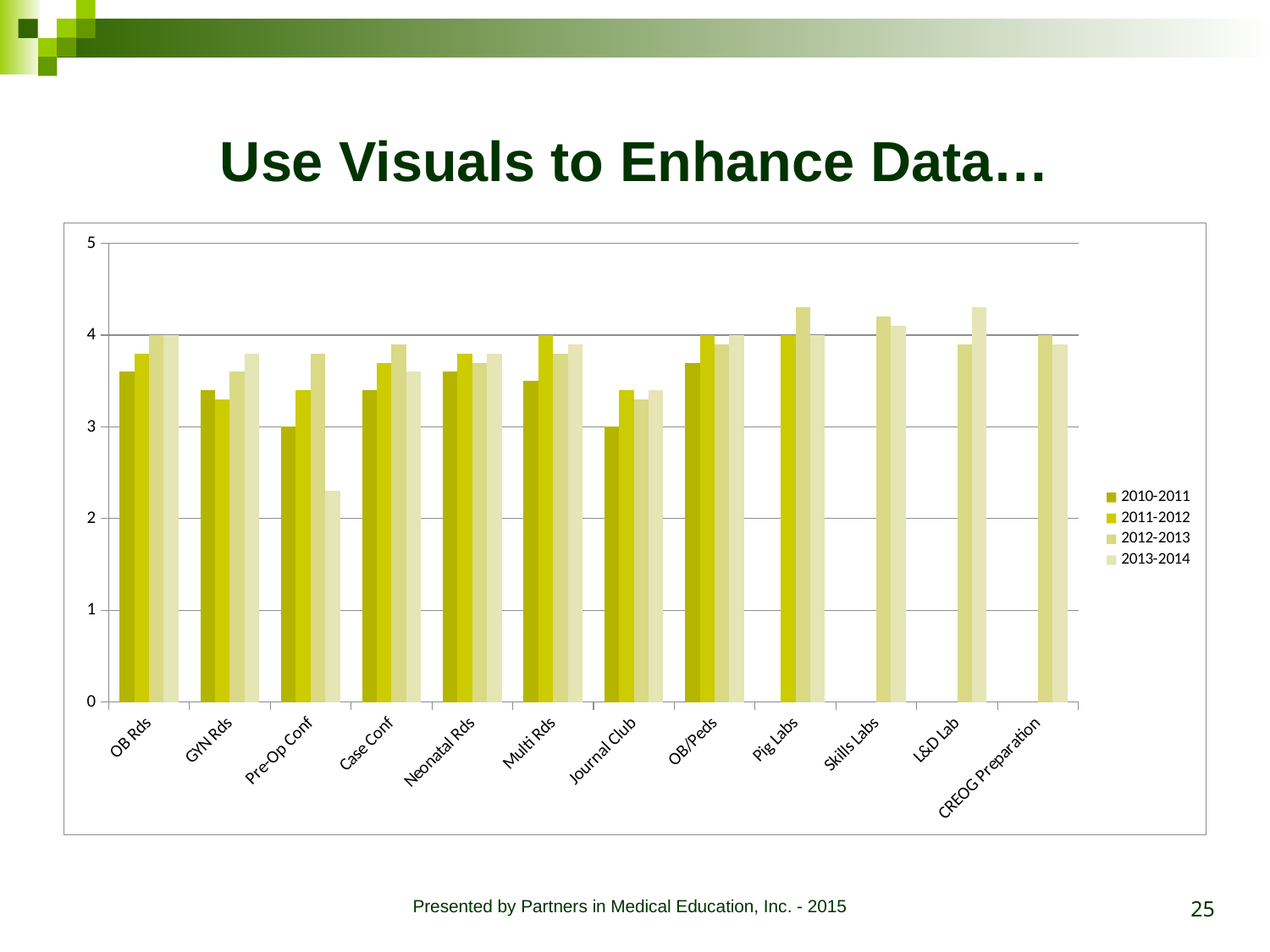
What is the value for Journal Club in the 2010-2011 series? 3 Which category has the lowest bar in the 2013-2014 series? Pre-Op Conf What is the value for Pre-Op Conf in the 2010-2011 series? 3 Is the value for GYN Rds in the 2011-2012 series greater or less than 4? less What is the title of the slide containing the chart? Use Visuals to Enhance Data… What kind of chart is shown on the slide? bar chart Which is larger for Pre-Op Conf: the 2012-2013 value or the 2013-2014 value? 2012-2013 How many series does the legend list? 4 Is the value for Skills Labs in the 2012-2013 series greater or less than 4? greater Is the value for Pre-Op Conf in the 2013-2014 series greater or less than 3? less What is the value for OB Rds in the 2013-2014 series? 4 How many categories are shown along the x axis? 12